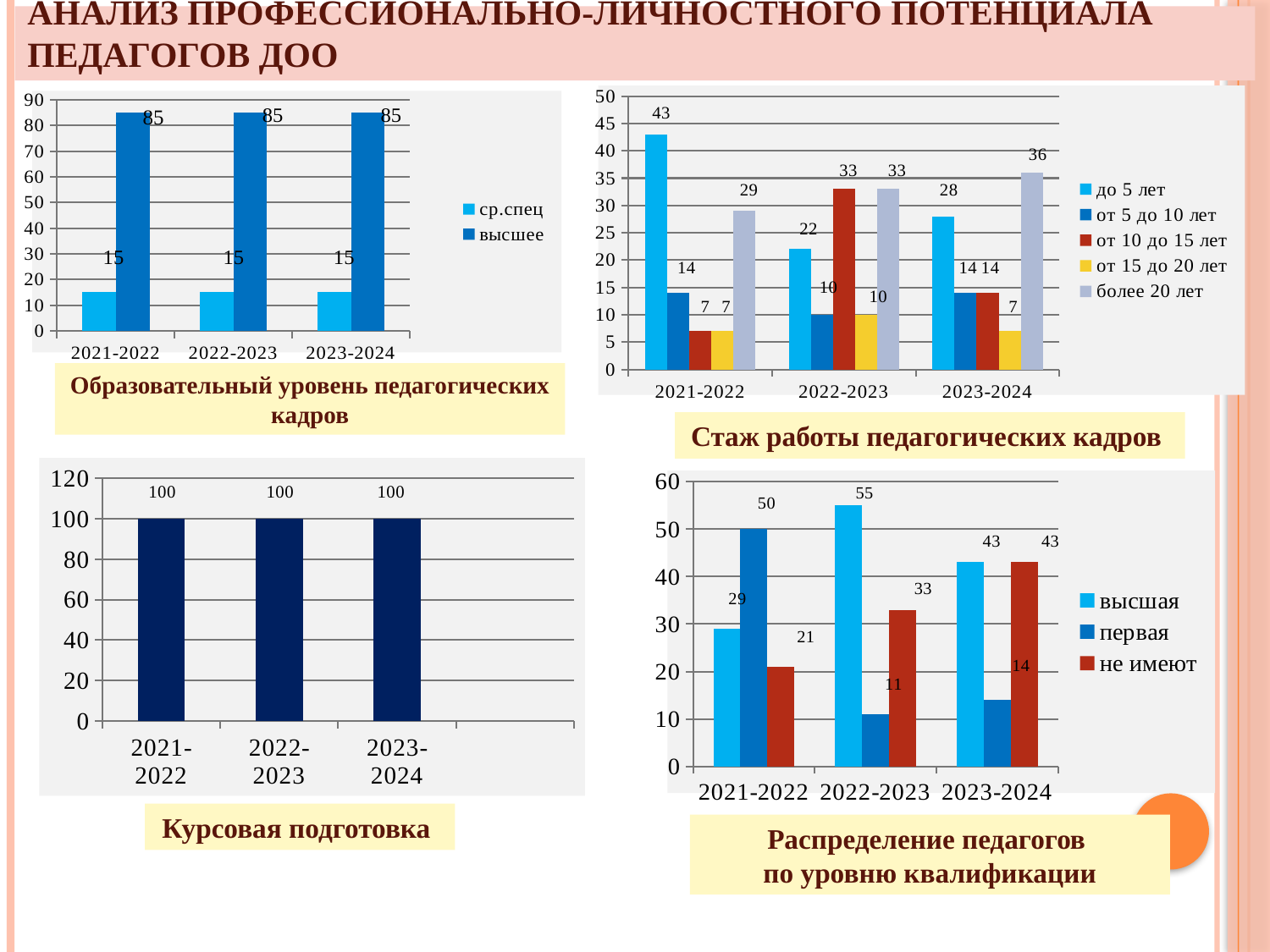
In the chart 'Распределение педагогов по уровню квалификации', which is larger in 2022-2023: 'первая' or 'не имеют'? не имеют What kind of chart is 'Курсовая подготовка'? Bar chart In the chart 'Стаж работы педагогических кадров', which series has the highest value in 2023-2024? более 20 лет In the chart 'Стаж работы педагогических кадров', what is the value for 'до 5 лет' in 2021-2022? 43 In the chart 'Курсовая подготовка', what is the value for 2023-2024? 100 In the chart 'Стаж работы педагогических кадров', how does the value for 'до 5 лет' change from 2021-2022 to 2022-2023? It falls from 43 to 22 In the chart 'Образовательный уровень педагогических кадров', what is the value for 'высшее' in 2022-2023? 85 In the chart 'Стаж работы педагогических кадров', what is the value for 'от 10 до 15 лет' in 2022-2023? 33 In the chart 'Распределение педагогов по уровню квалификации', what is the value for 'первая' in 2021-2022? 50 In the chart 'Распределение педагогов по уровню квалификации', which category has the highest value for 'высшая'? 2022-2023 In the chart 'Образовательный уровень педагогических кадров', what is the difference between 'высшее' and 'ср.спец' in 2021-2022? 70 How many series does the legend list in the chart 'Стаж работы педагогических кадров'? 5